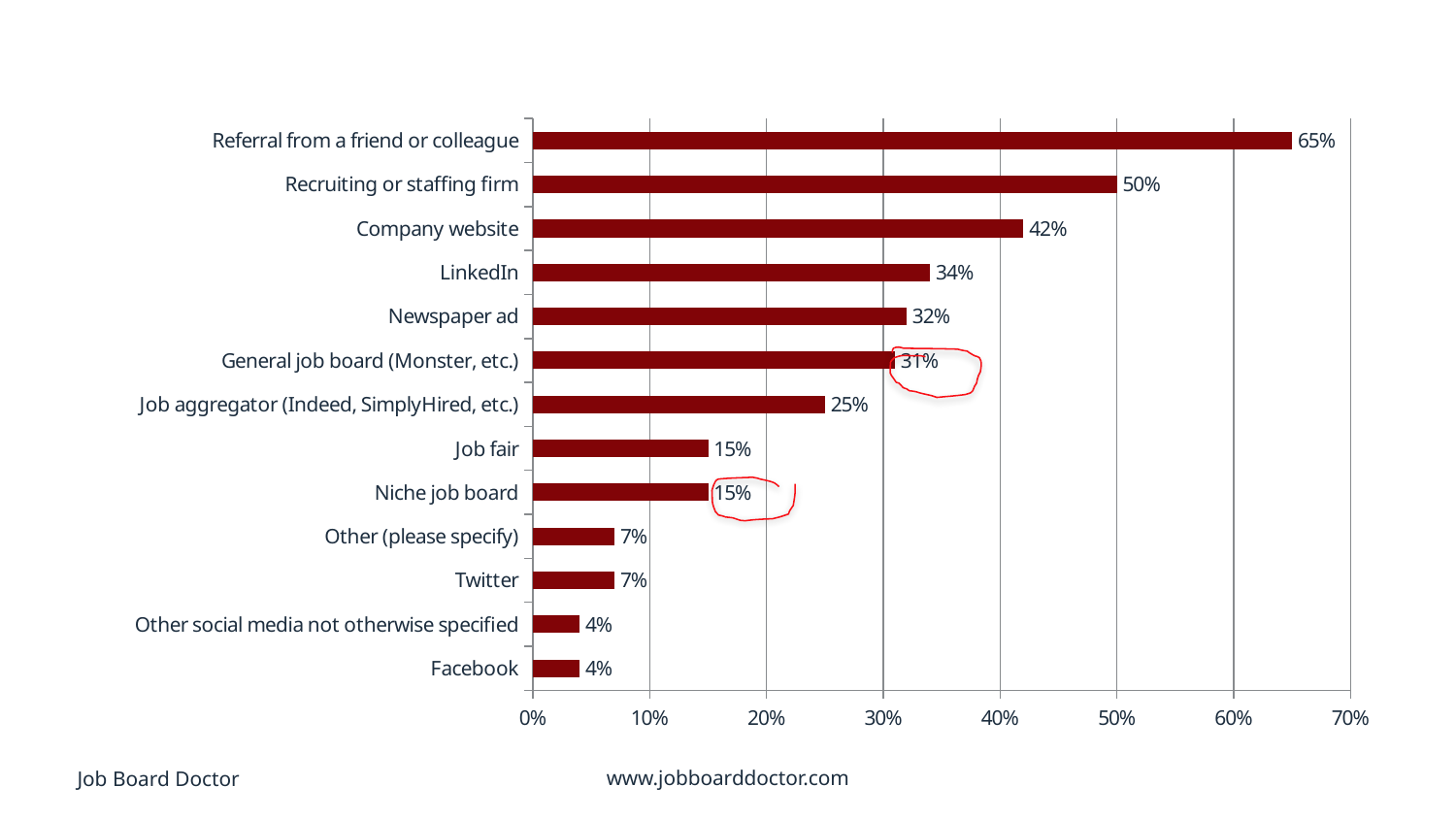
What is the value for Company website? 42% What is the value for General job board (Monster, etc.)? 31% What is the maximum value shown on the horizontal axis? 70% Which is larger, Newspaper ad or Job fair? Newspaper ad What is the value for Twitter? 7% Which category has the highest value? Referral from a friend or colleague What kind of chart is shown on the slide? Bar chart What is the difference between Recruiting or staffing firm and LinkedIn? 16% What is the value for Referral from a friend or colleague? 65% Is the value for Company website greater or less than 40%? greater What is the value for Job aggregator (Indeed, SimplyHired, etc.)? 25% How many categories are shown in the chart? 13